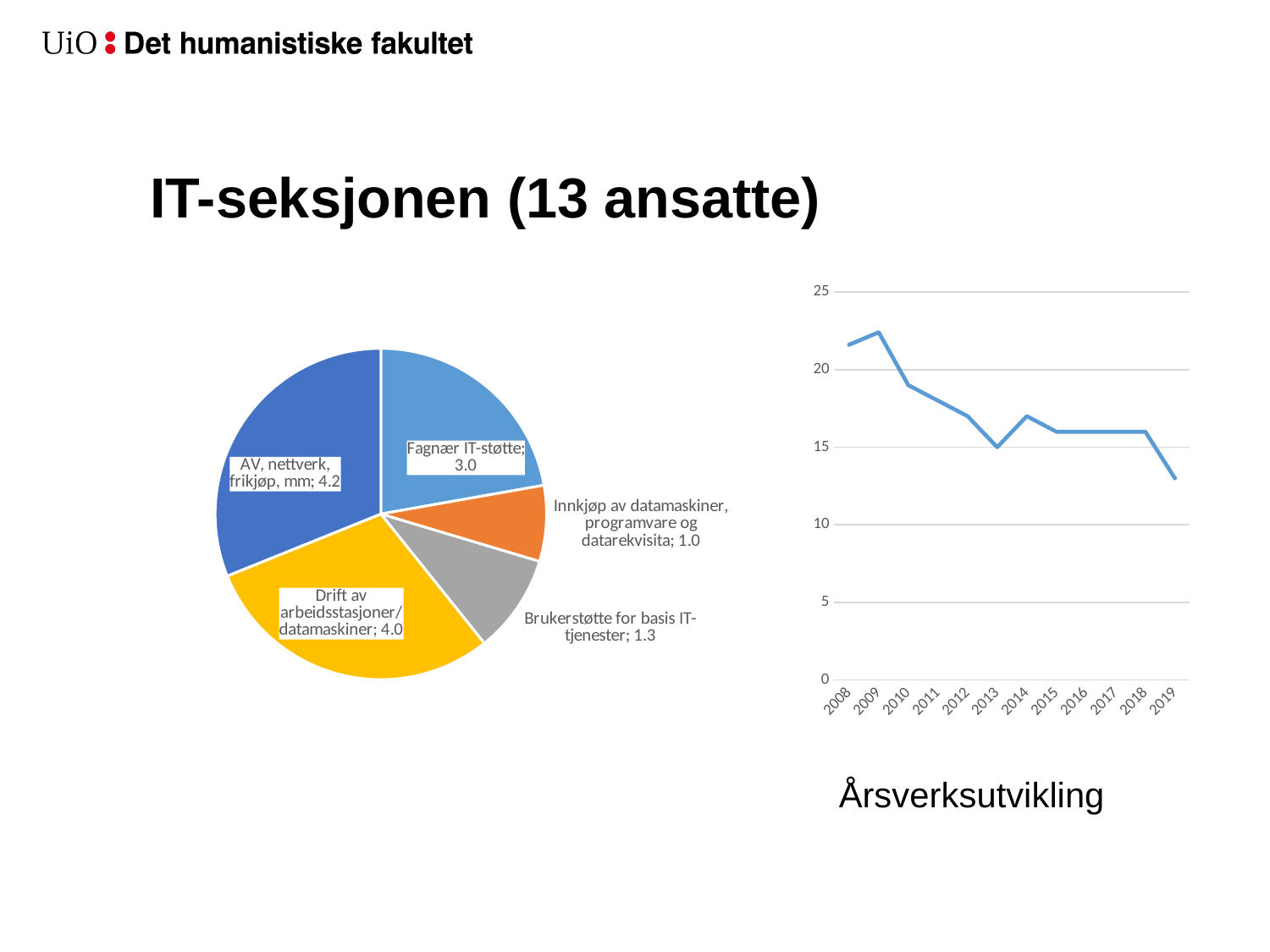
How many slices does the pie chart on the left have? 5 On the 'Årsverksutvikling' chart, is the value for 2019 greater or less than 15? less What kind of chart is the 'Årsverksutvikling' chart on the right? Line chart On the pie chart on the left, what is the value for 'Fagnær IT-støtte'? 3.0 On the pie chart on the left, what is the difference between 'Drift av arbeidsstasjoner/datamaskiner' and 'Fagnær IT-støtte'? 1.0 On the 'Årsverksutvikling' chart, is the value for 2009 greater or less than 20? greater On the pie chart on the left, which is larger: 'Brukerstøtte for basis IT-tjenester' or 'Innkjøp av datamaskiner, programvare og datarekvisita'? Brukerstøtte for basis IT-tjenester On the 'Årsverksutvikling' chart, do the values generally rise or fall from 2008 to 2019? Fall On the pie chart on the left, what is the value for 'AV, nettverk, frikjøp, mm'? 4.2 On the pie chart on the left, which category has the largest slice? AV, nettverk, frikjøp, mm On the pie chart on the left, which category has the smallest slice? Innkjøp av datamaskiner, programvare og datarekvisita On the pie chart on the left, what is the value for 'Brukerstøtte for basis IT-tjenester'? 1.3